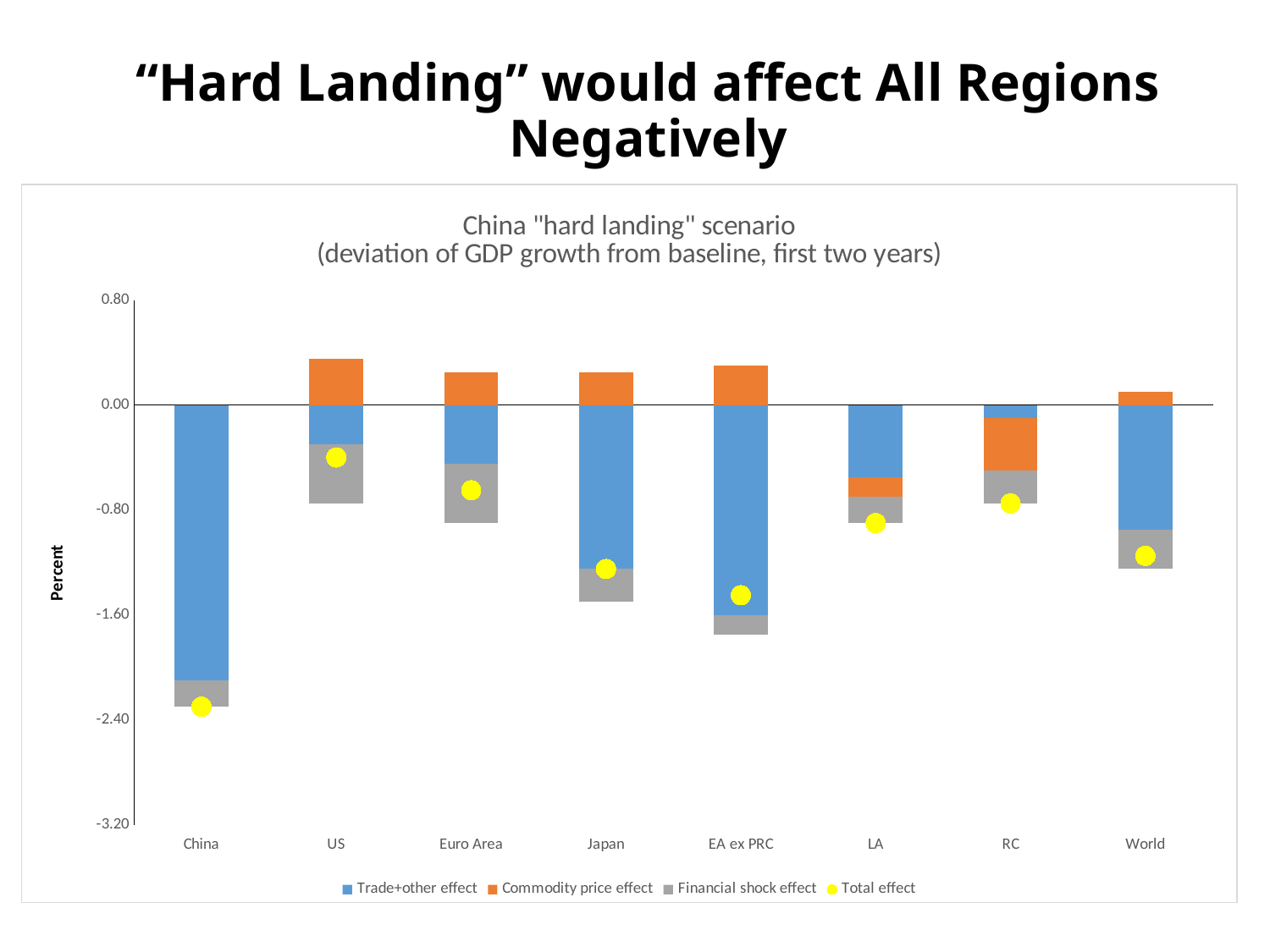
Which region has the lowest (most negative) Total effect? China How many regions are shown on the x axis of the chart? 8 Is the Total effect for Japan greater or less than -0.80? less What type of chart is shown on the slide? bar chart Which region has the highest (least negative) Total effect? US What is the label on the vertical axis of the chart? Percent Is the Total effect for World greater or less than -0.80? less What is the title of the chart? China "hard landing" scenario (deviation of GDP growth from baseline, first two years) Which has the more negative Total effect, China or US? China Is the Total effect for China greater or less than -1.60? less How many series does the chart legend list? 4